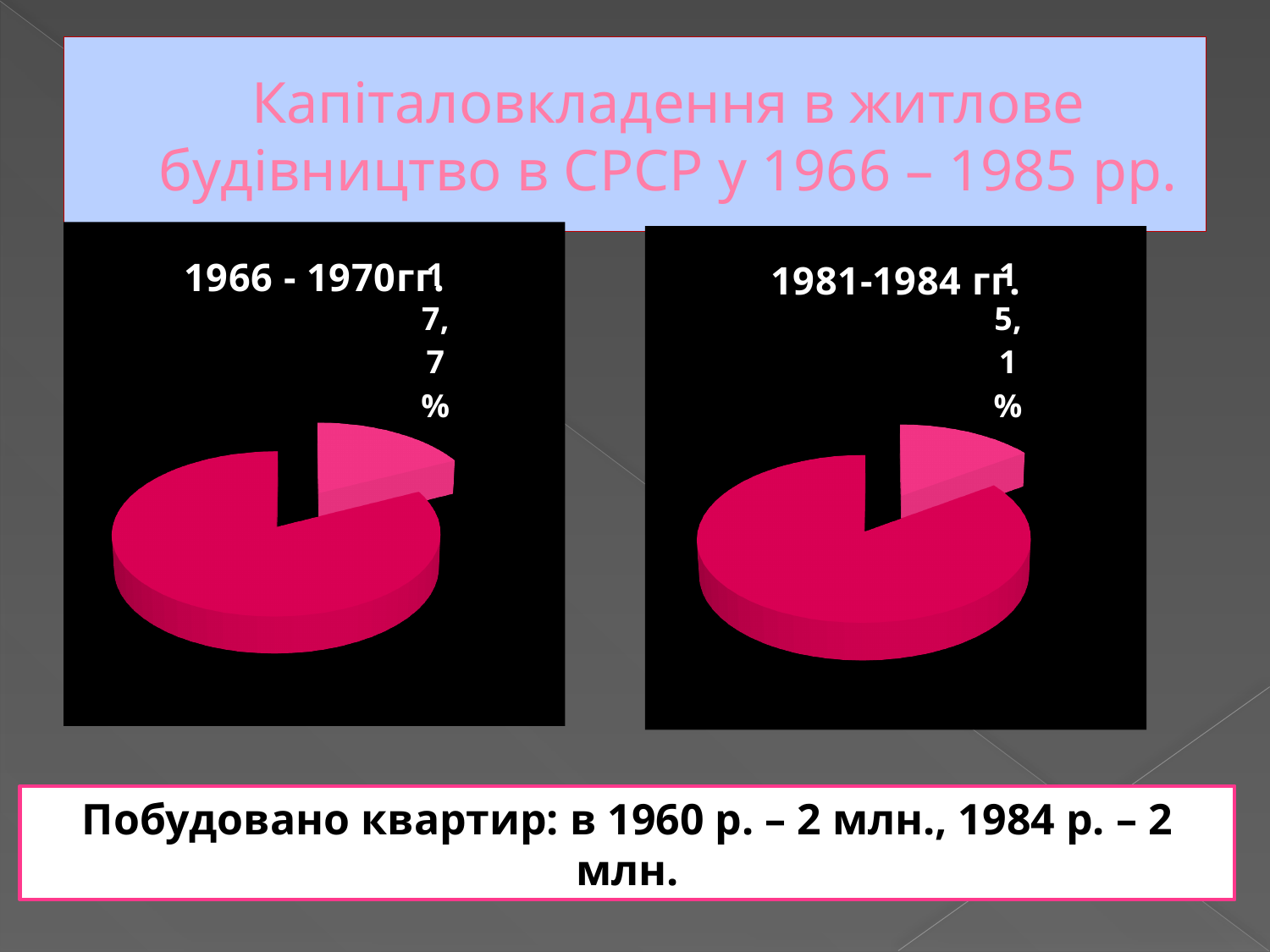
In the left chart (1966 - 1970гг.), what value is printed on the small exploded slice? 17,7% What kind of chart is the right chart titled "1981-1984 гг."? pie chart How many slices does the right chart (1981-1984 гг.) have? 2 In the right chart (1981-1984 гг.), what value is printed on the small exploded slice? 15,1% What is the difference between the labelled slice in the left chart (17,7%) and the labelled slice in the right chart (15,1%)? 2,6% How many slices does the left chart (1966 - 1970гг.) have? 2 In the left chart (1966 - 1970гг.), which slice is larger, the exploded slice or the remaining slice? the remaining slice What kind of chart is the left chart titled "1966 - 1970гг."? pie chart Which chart has the larger labelled small slice, the left chart (1966 - 1970гг.) or the right chart (1981-1984 гг.)? the left chart (1966 - 1970гг.) What is the title of the right chart? 1981-1984 гг. What is the title of the left chart? 1966 - 1970гг.